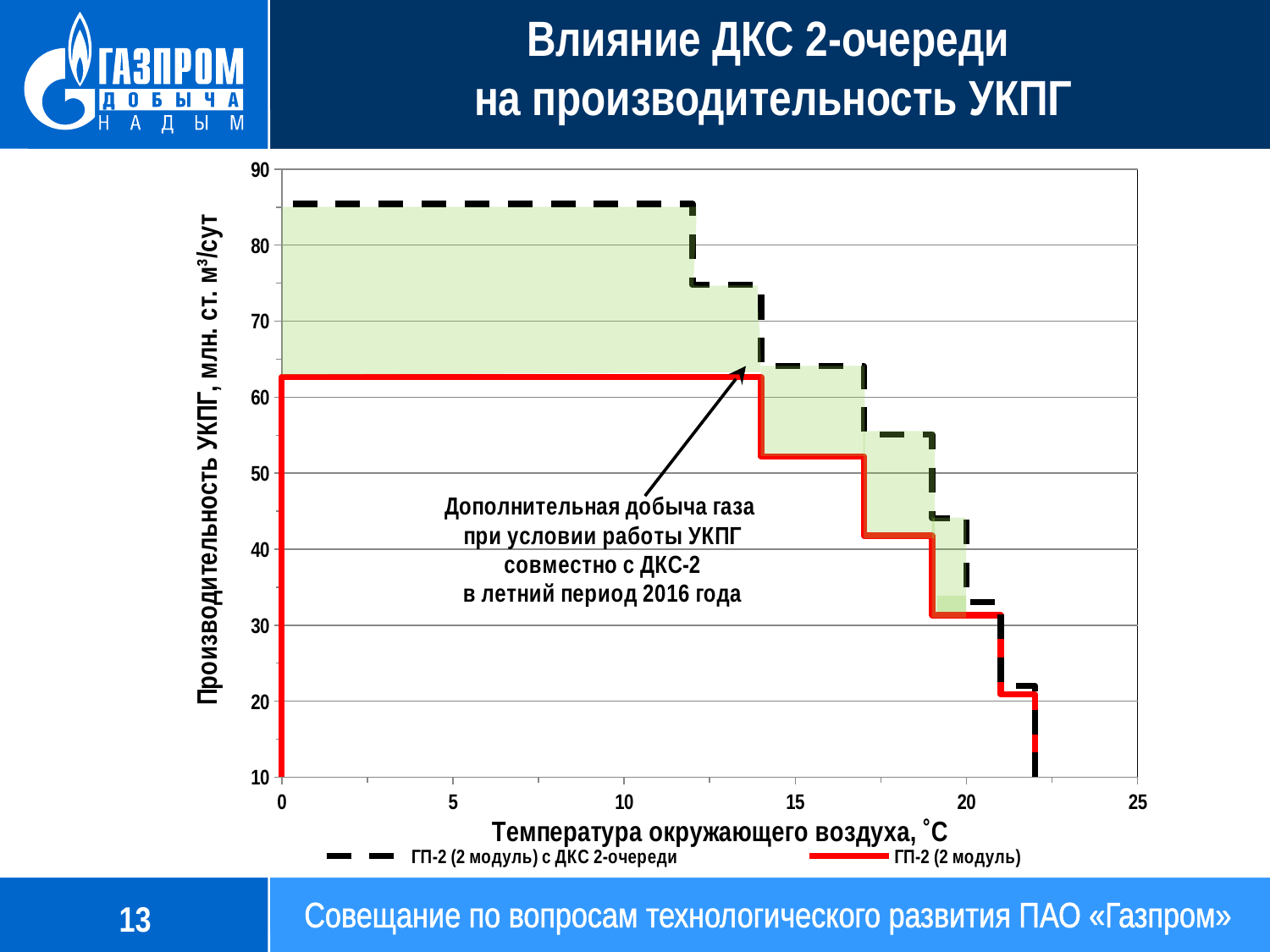
Is the value of the red series ГП-2 (2 модуль) at 5 °C greater or less than 60? greater Do the values of the series rise or fall as the air temperature increases along the x axis? fall Is the value of the dashed series ГП-2 (2 модуль) с ДКС 2-очереди at 5 °C greater or less than 80? greater Is the value of the red series ГП-2 (2 модуль) at 15 °C greater or less than 60? less What are the two series named in the legend? ГП-2 (2 модуль) с ДКС 2-очереди and ГП-2 (2 модуль) What is the label of the x axis? Температура окружающего воздуха, °C What kind of chart is shown on the slide? line chart How many series does the legend list? 2 At 10 °C, which series has the higher value: ГП-2 (2 модуль) с ДКС 2-очереди or ГП-2 (2 модуль)? ГП-2 (2 модуль) с ДКС 2-очереди